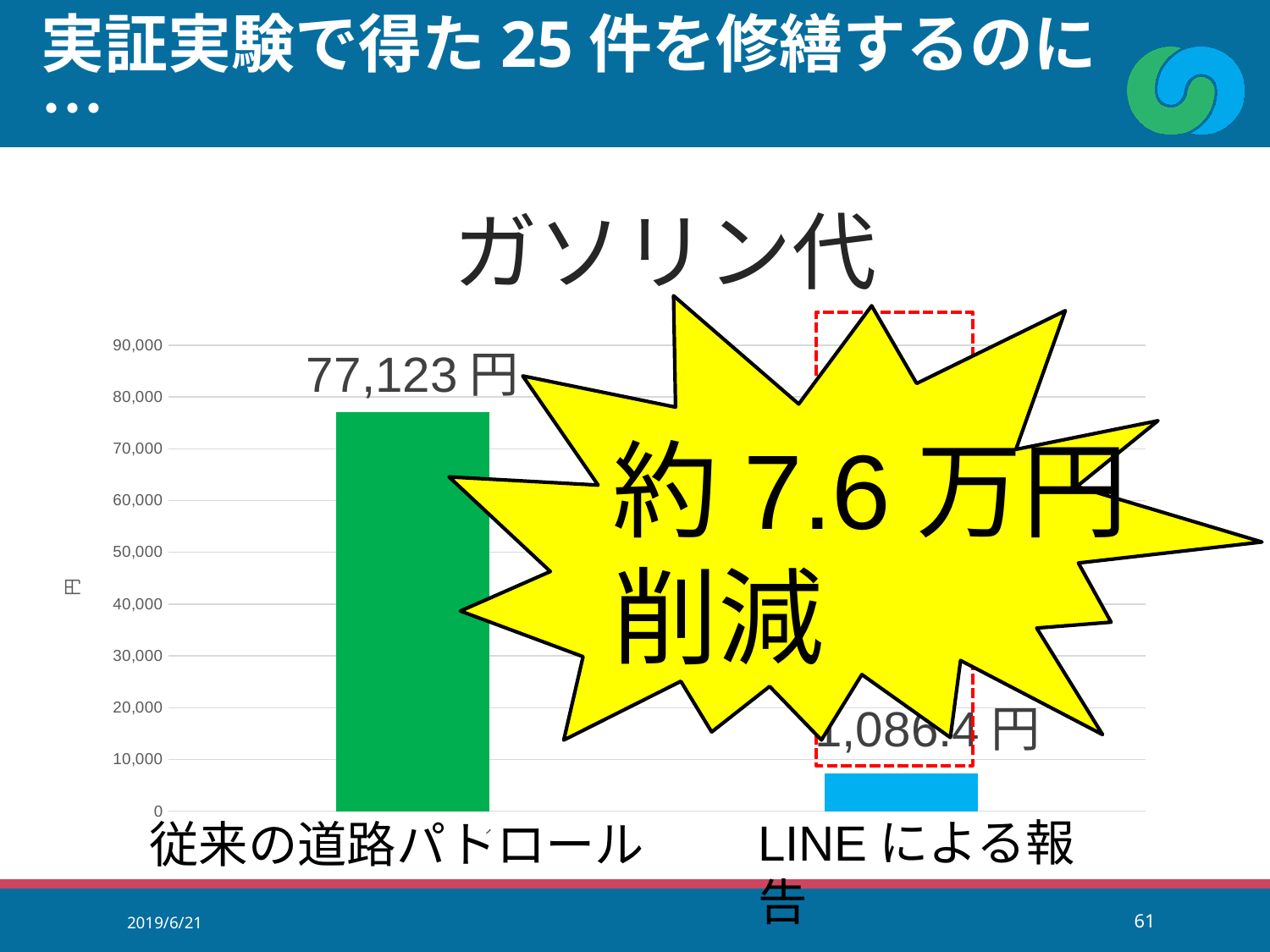
Is the value for LINE による報告 greater or less than 10,000? less Which is larger, the value for 従来の道路パトロール or the value for LINE による報告? 従来の道路パトロール What is the label on the vertical axis? 円 Which category has the highest value? 従来の道路パトロール Do the values rise or fall from left to right across the categories? fall What is the value for 従来の道路パトロール? 77,123 円 Which category has the lowest value? LINE による報告 What is the title of the chart? ガソリン代 Is the value for 従来の道路パトロール greater or less than 70,000? greater What type of chart is shown on the slide? bar chart How many categories are plotted in the chart? 2